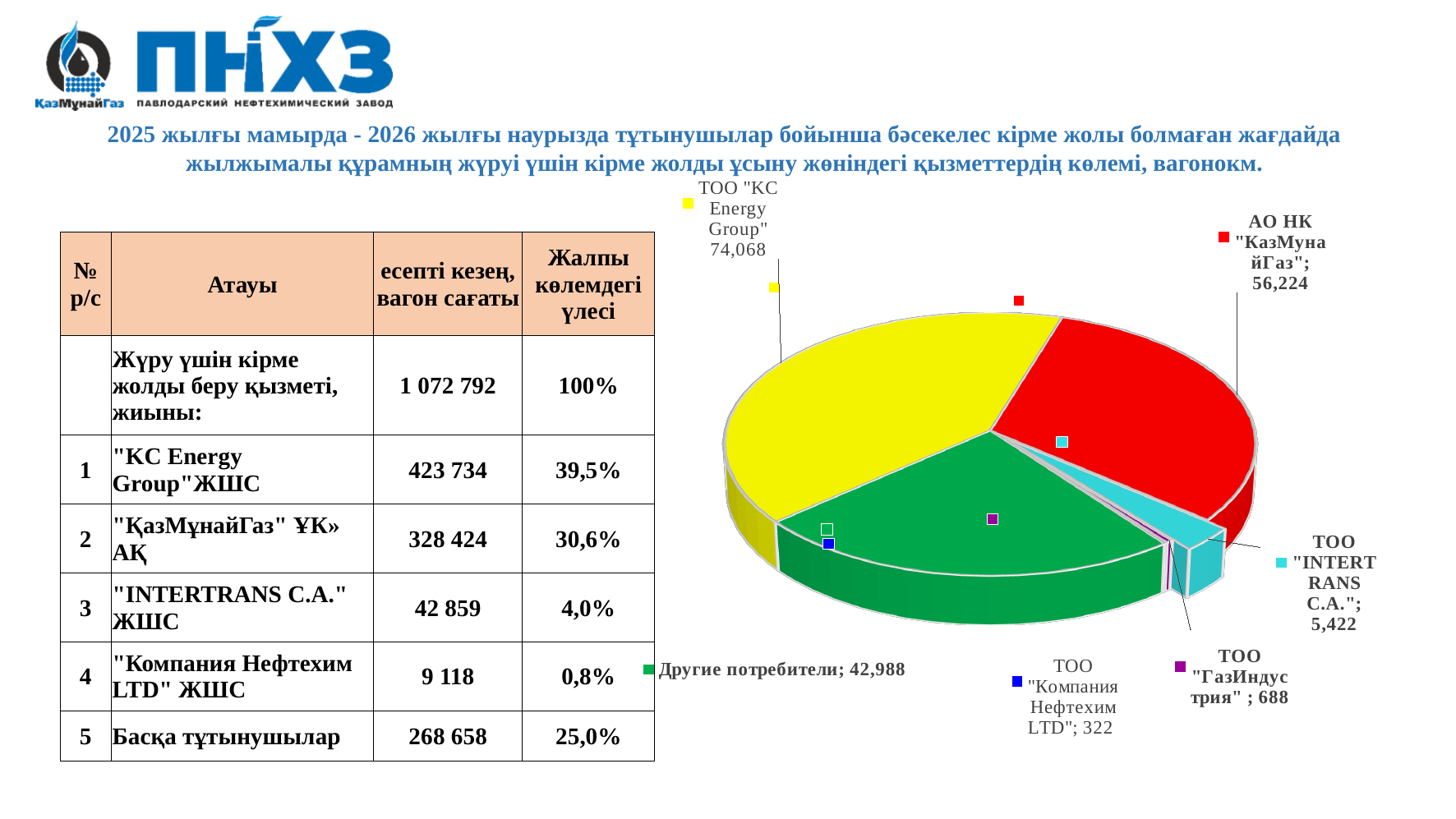
What is the value shown for ТОО "ГазИндустрия" in the pie chart? 688 What is the difference between the values for ТОО "KC Energy Group" and АО НК "КазМунайГаз" in the pie chart? 17,844 What colour is the slice for ТОО "KC Energy Group" in the pie chart? yellow What is the value shown for Другие потребители in the pie chart? 42,988 In the pie chart, which is larger: the value for АО НК "КазМунайГаз" or the value for Другие потребители? АО НК "КазМунайГаз" What kind of chart is shown on the slide? pie chart How many slices does the pie chart have? 6 What is the value shown for ТОО "INTERTRANS C.A." in the pie chart? 5,422 What is the value shown for ТОО "KC Energy Group" in the pie chart? 74,068 Which category has the largest slice in the pie chart? ТОО "KC Energy Group" What is the value shown for АО НК "КазМунайГаз" in the pie chart? 56,224 Which category has the smallest slice in the pie chart? ТОО "Компания Нефтехим LTD"